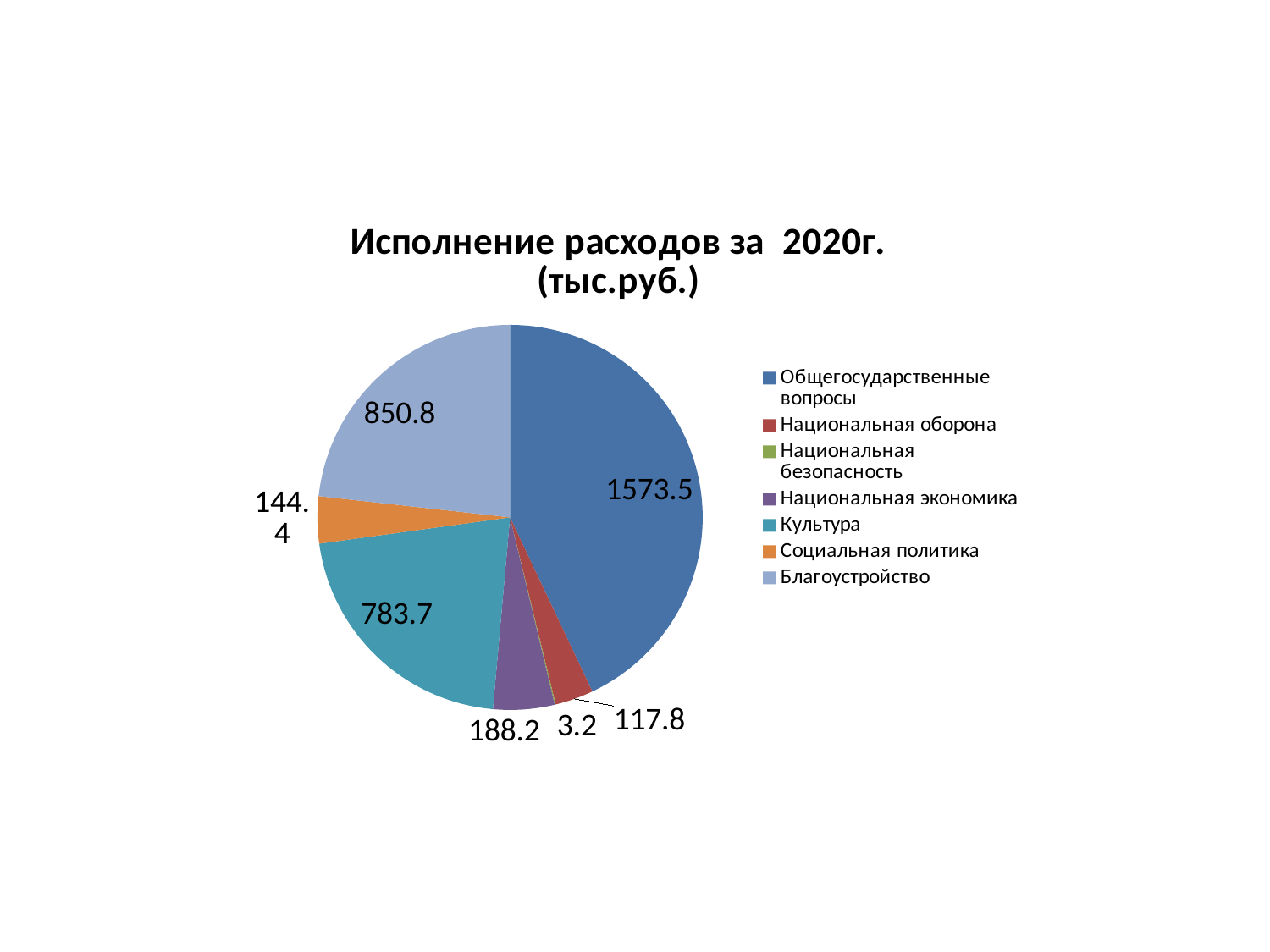
What type of chart is shown on the slide? Pie chart How many categories does the pie chart show? 7 What is the value for Культура? 783.7 What is the difference between Национальная экономика and Социальная политика? 43.8 What is the title of the chart? Исполнение расходов за 2020г. (тыс.руб.) What is the value for Национальная безопасность? 3.2 Which is larger, Благоустройство or Культура? Благоустройство Which category has the smallest slice? Национальная безопасность What is the value for Общегосударственные вопросы? 1573.5 What is the difference between Общегосударственные вопросы and Благоустройство? 722.7 What is the value for Социальная политика? 144.4 Which category has the largest slice? Общегосударственные вопросы